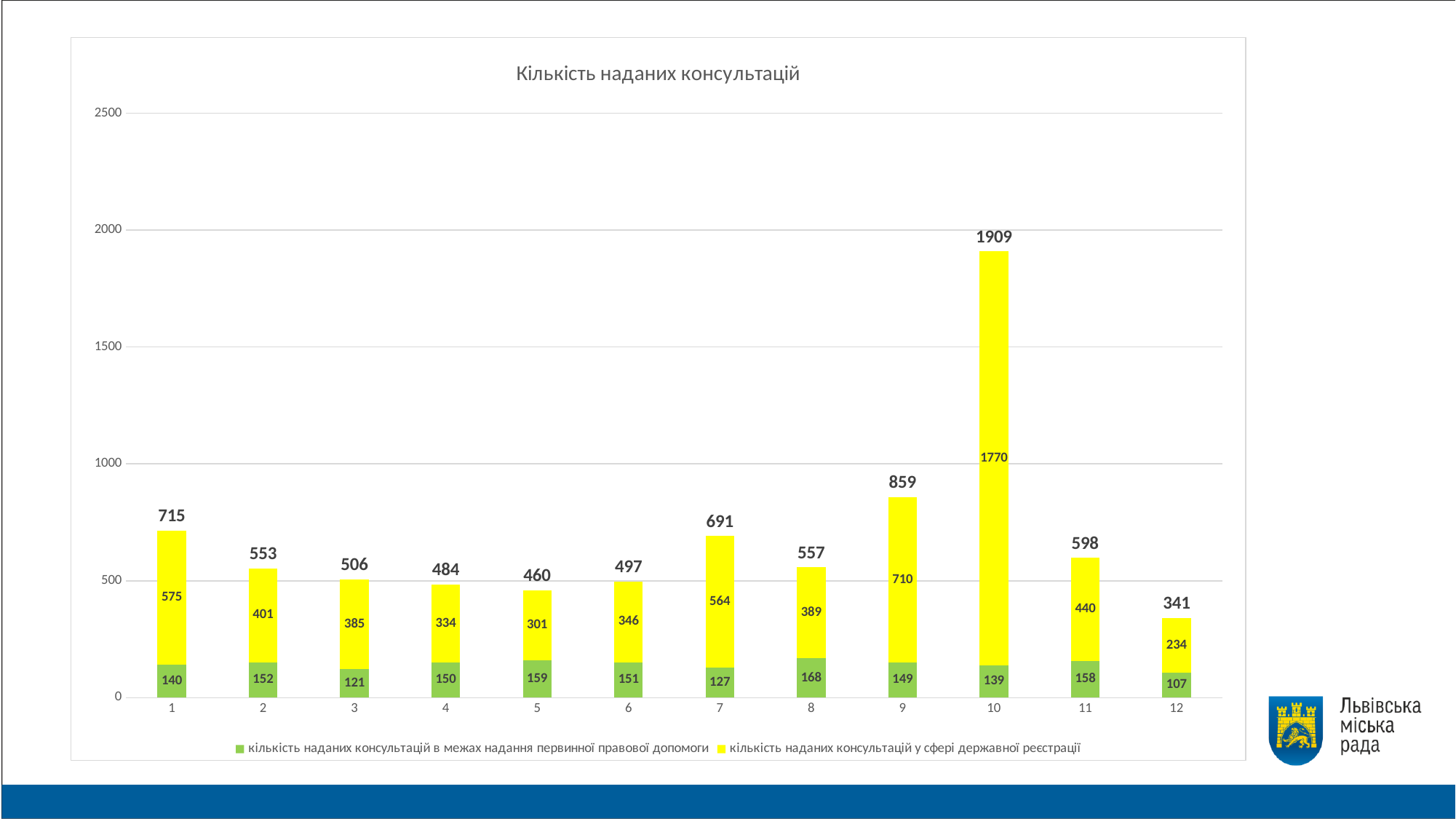
How many categories are shown on the x axis? 12 Which category has the highest total? 10 Is the total for category 10 greater or less than 1500? greater What is the value of the green series (кількість наданих консультацій в межах надання первинної правової допомоги) for category 8? 168 What type of chart is shown on the slide? Stacked bar chart What is the title of the chart? Кількість наданих консультацій What is the difference between the totals for category 1 and category 2? 162 What is the value of the yellow series (кількість наданих консультацій у сфері державної реєстрації) for category 10? 1770 Which category has the lowest total? 12 How many series does the legend list? 2 What is the total of the stacked bar for category 9? 859 Which is larger: the total for category 7 or the total for category 11? Category 7